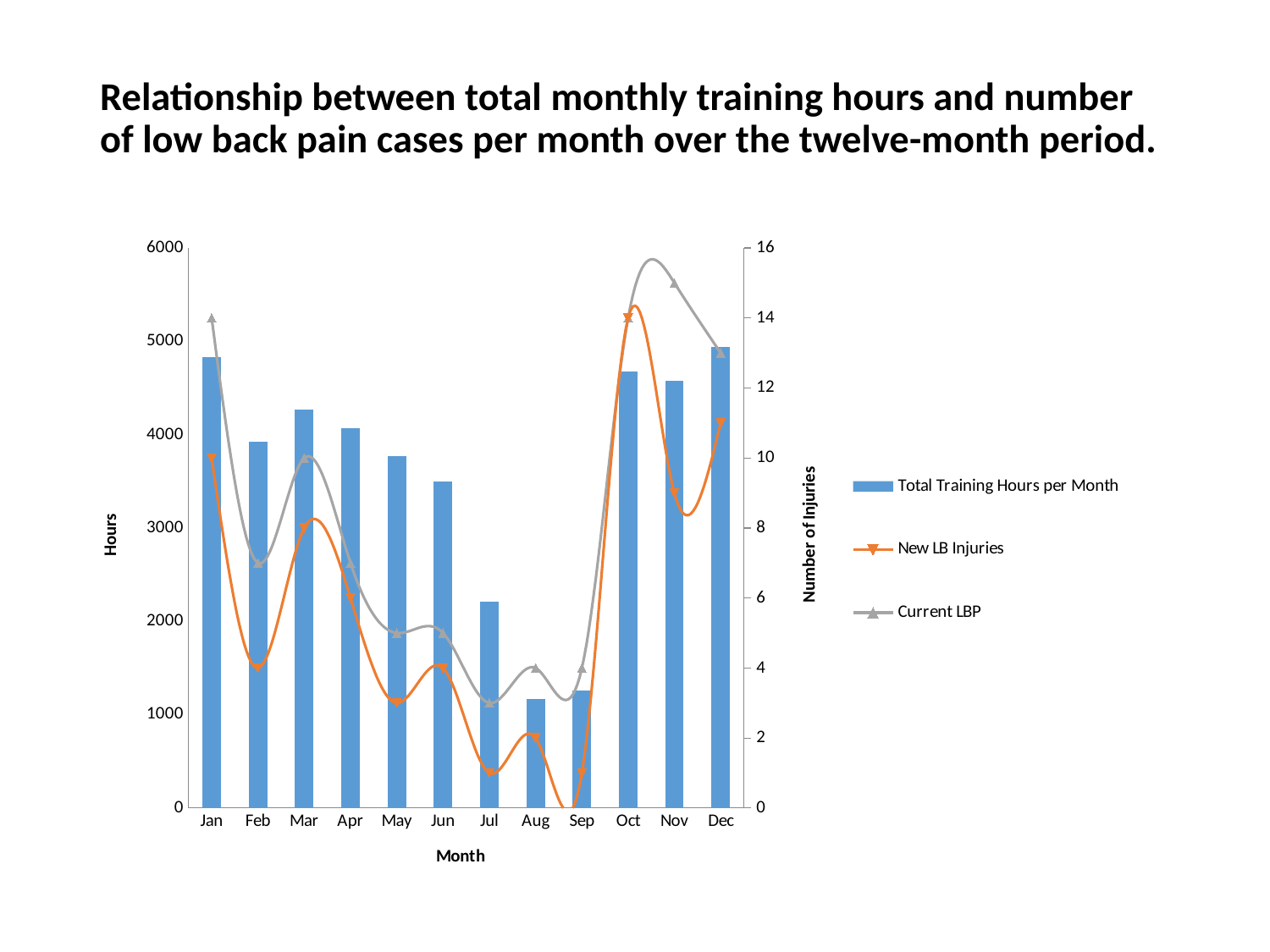
Which month has the lowest Total Training Hours per Month? Aug Is the Total Training Hours per Month value for Jul greater or less than 3000? less Which month has more Total Training Hours per Month, Feb or Mar? Mar How many series does the legend list? 3 What is the value of New LB Injuries in Oct? 14 Is the Total Training Hours per Month value for Jan greater or less than 4000? greater What is the value of New LB Injuries in Jan? 10 What is the value of Current LBP in Jan? 14 What is the title of the right-hand vertical axis? Number of Injuries What kind of chart is shown on the slide? A combination bar and line chart How many months are shown along the x axis? 12 Which month has the highest value for New LB Injuries? Oct